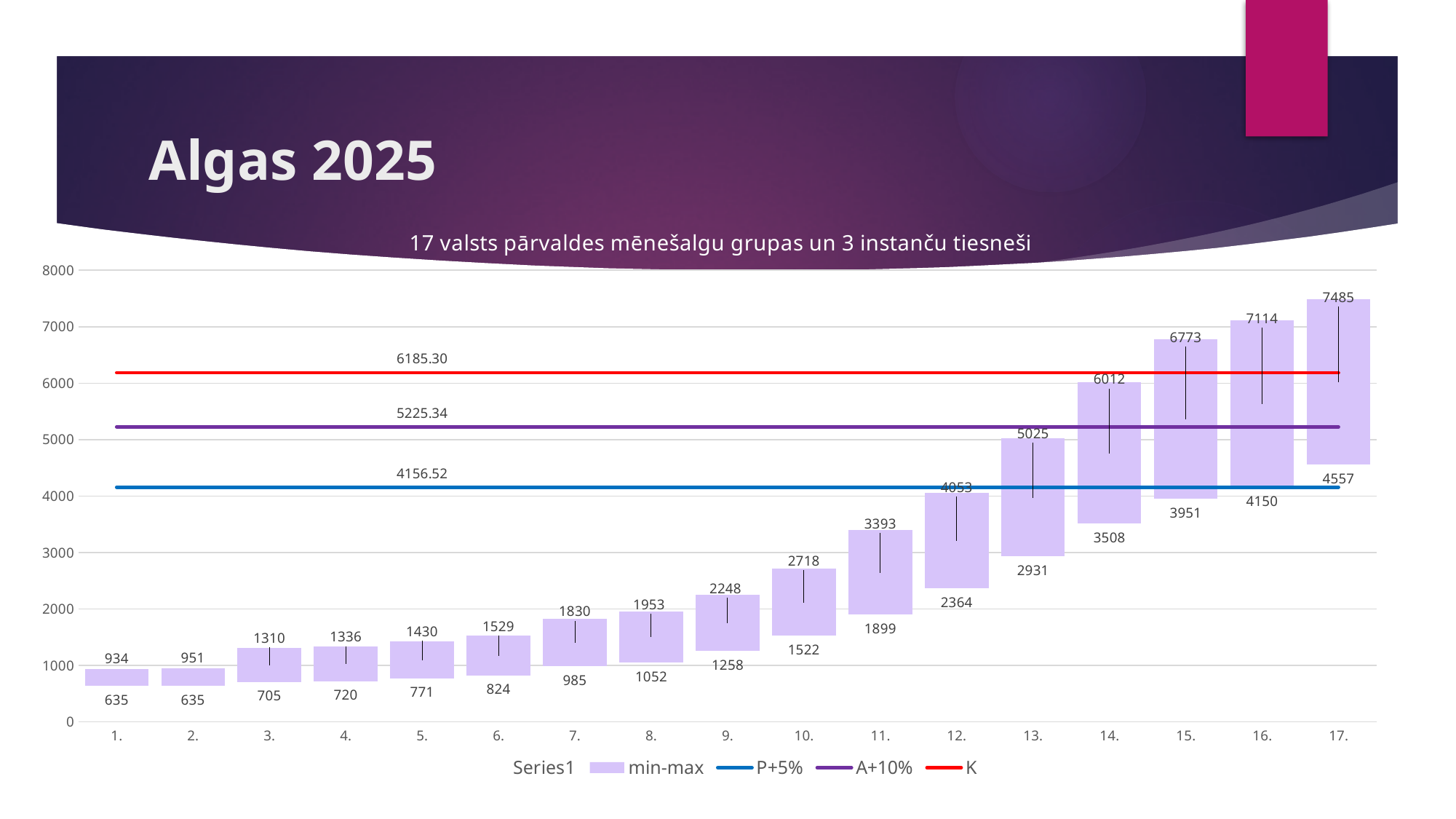
What is the minimum value shown for group 13.? 2931 What value is labelled on the blue P+5% line? 4156.52 What is the minimum value shown for group 1.? 635 Which is larger, the maximum value for group 9. or the maximum value for group 10.? group 10. Is the maximum value for group 12. greater or less than 4000? greater What value is labelled on the red K line? 6185.30 What is the maximum value shown for group 17.? 7485 How many groups are shown on the x axis? 17 What is the difference between the maximum and minimum values for group 14.? 2504 Which group has the highest maximum value? 17. How many entries does the legend list? 5 What is the subtitle shown above the chart? 17 valsts pārvaldes mēnešalgu grupas un 3 instanču tiesneši